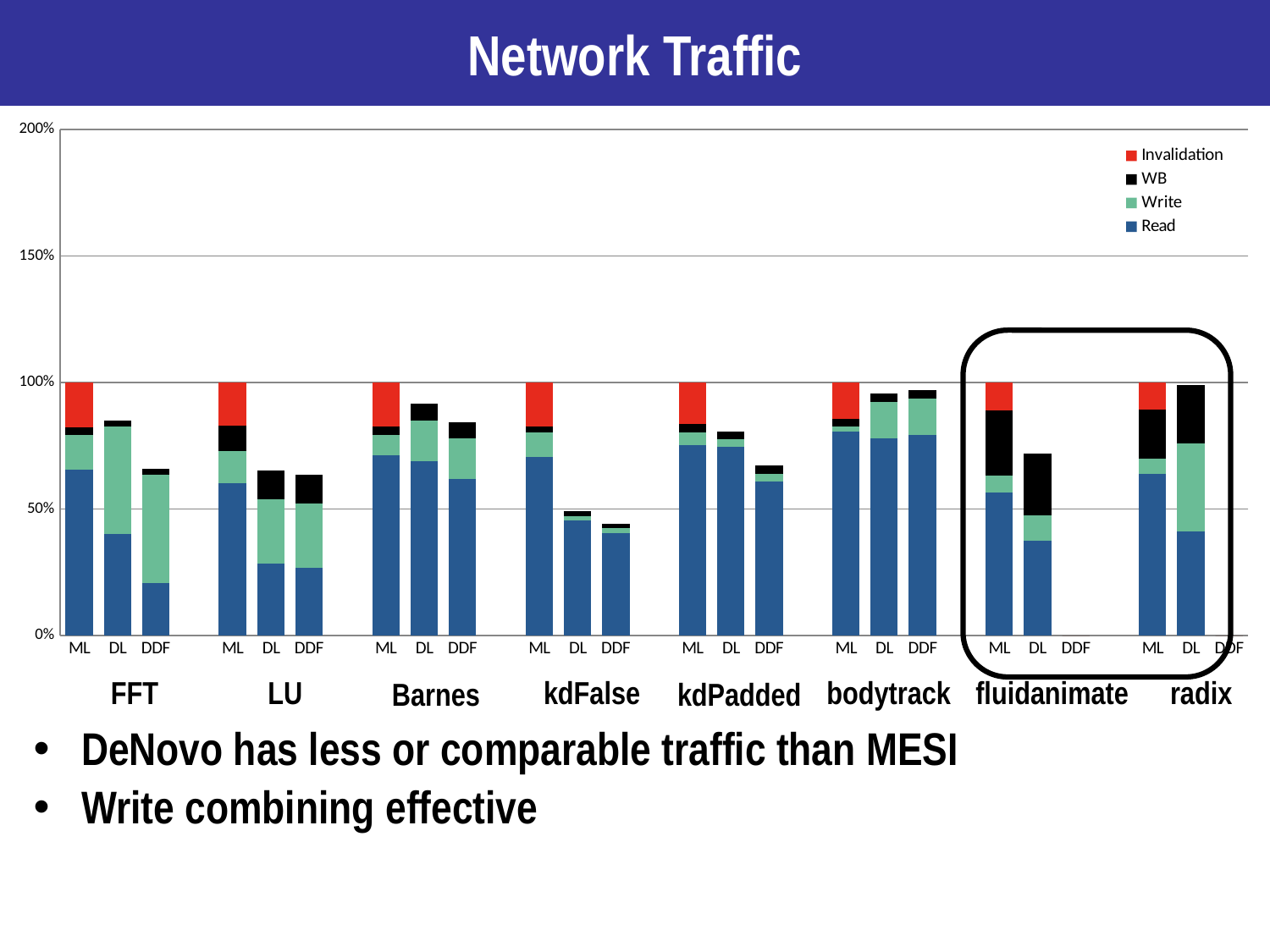
Which bar has the larger total, kdFalse ML or kdFalse DL? kdFalse ML Is the total value of the FFT DDF bar greater or less than 100%? less How many series does the legend list? 4 Is the total value of the Barnes ML bar greater or less than 50%? greater Which bar has the larger total, FFT DL or FFT DDF? FFT DL Is the total value of the LU DL bar greater or less than 100%? less How many benchmark groups are shown along the x axis? 8 What kind of chart is shown on the slide? stacked bar chart What colour represents the Read series? blue Which bar has the larger total, fluidanimate ML or fluidanimate DL? fluidanimate ML Which legend entry is listed first (at the top)? Invalidation